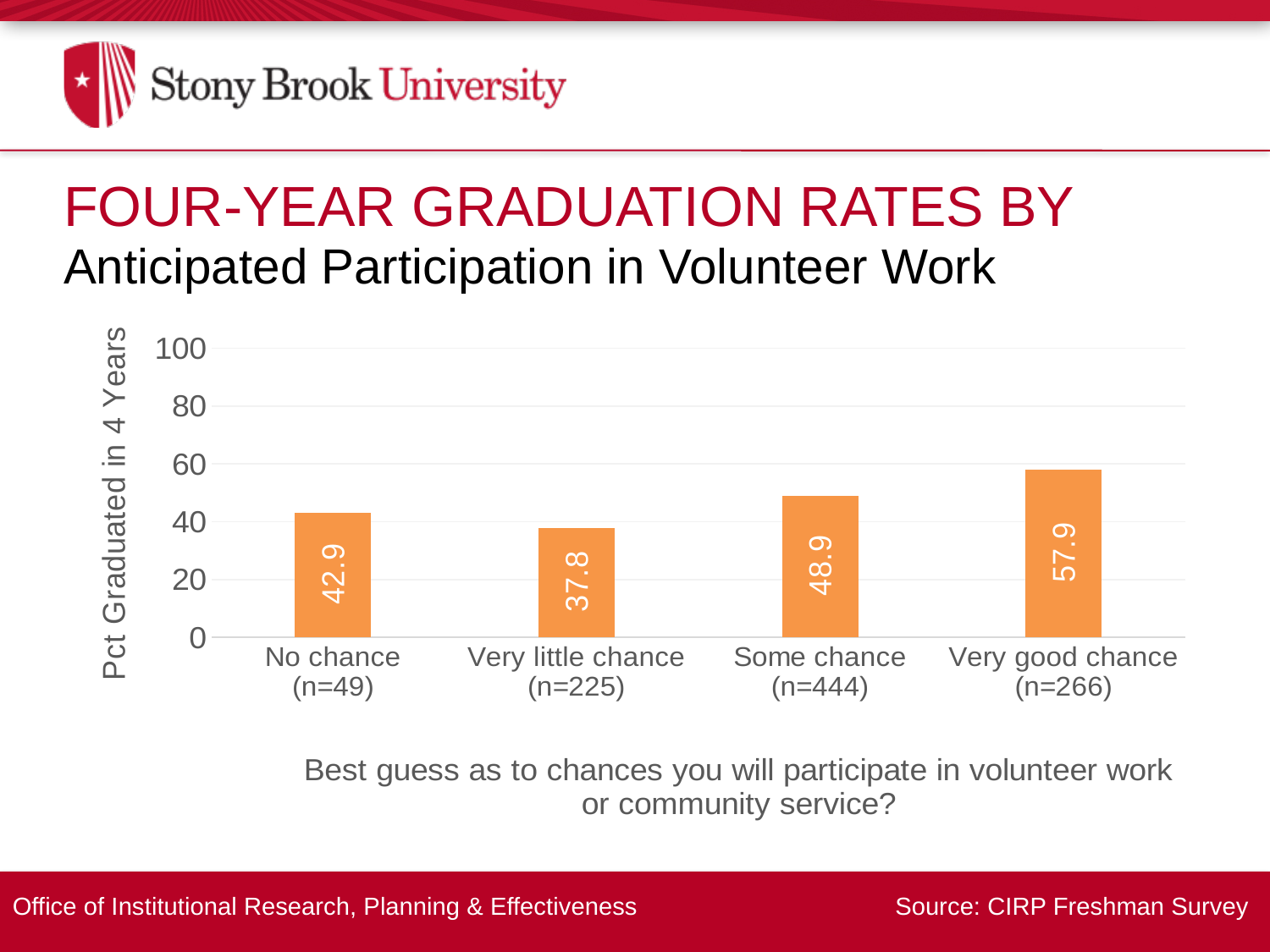
What is the four-year graduation rate for students who said 'No chance' of participating in volunteer work? 42.9 How many response categories are shown on the x axis? 4 Is the four-year graduation rate for the 'Very little chance' group greater or less than 40? less Which response category has the highest four-year graduation rate? Very good chance What is the four-year graduation rate for the 'Very little chance' group? 37.8 What type of chart is shown on the slide? Bar chart What is the difference in four-year graduation rate between the 'Very good chance' and 'No chance' groups? 15 What is the sample size (n) for the 'Some chance' group? 444 Which group has a higher four-year graduation rate: 'Some chance' or 'No chance'? Some chance What is the four-year graduation rate for the 'Some chance' group? 48.9 Which response category has the lowest four-year graduation rate? Very little chance What is the four-year graduation rate for the 'Very good chance' group? 57.9